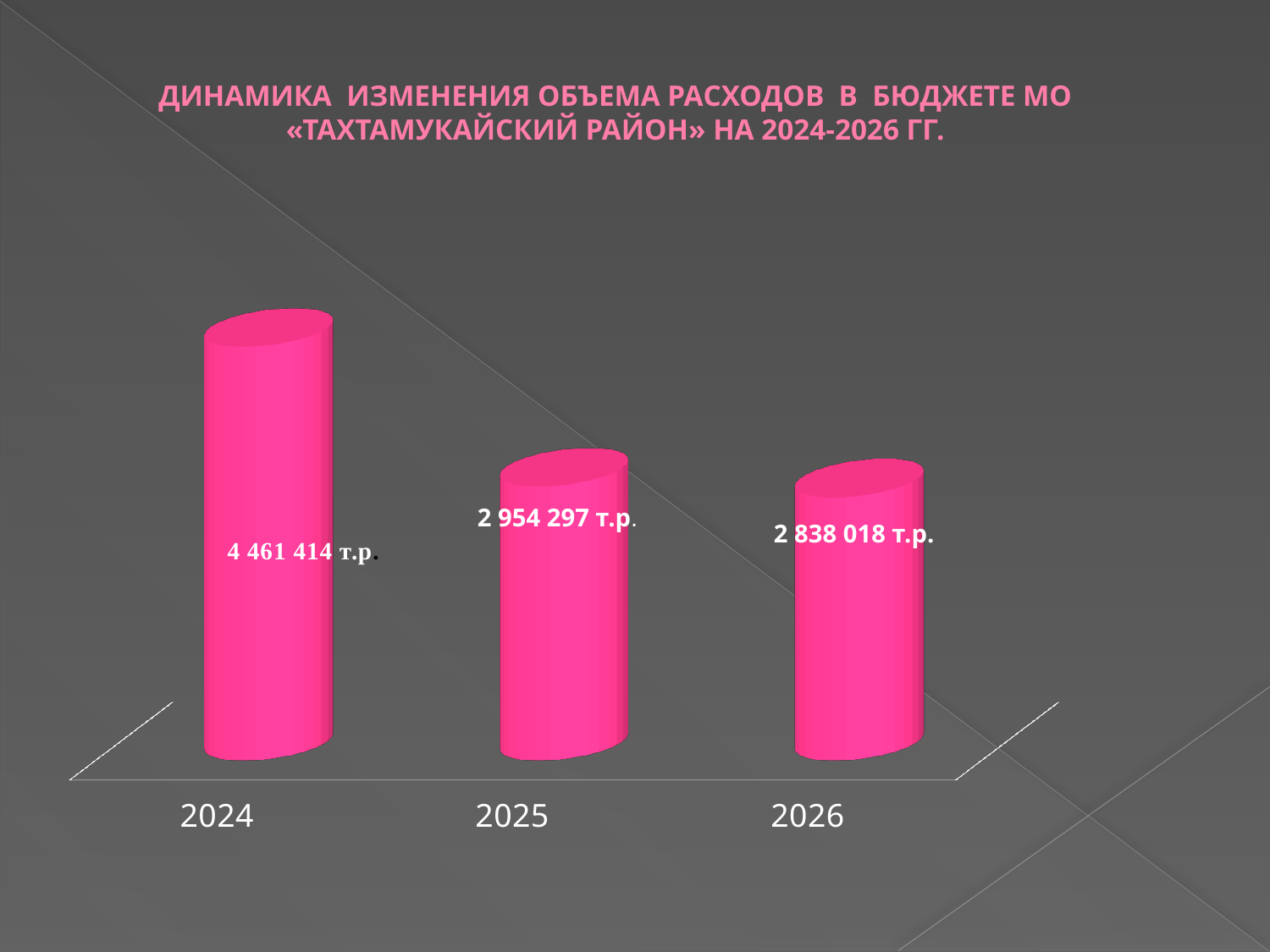
Which year has the lowest value? 2026 What is the value shown for 2026? 2 838 018 т.р. What is the difference between the values for 2025 and 2026? 116 279 т.р. What is the value shown for 2025? 2 954 297 т.р. What is the difference between the values for 2024 and 2025? 1 507 117 т.р. How many years are shown on the chart? 3 What is the difference between the values for 2024 and 2026? 1 623 396 т.р. What is the value shown for 2024? 4 461 414 т.р. Do the values rise or fall from 2024 to 2026? Fall What kind of chart is shown on the slide? Bar chart Which is larger, the value for 2024 or the value for 2026? 2024 Which year has the highest value? 2024